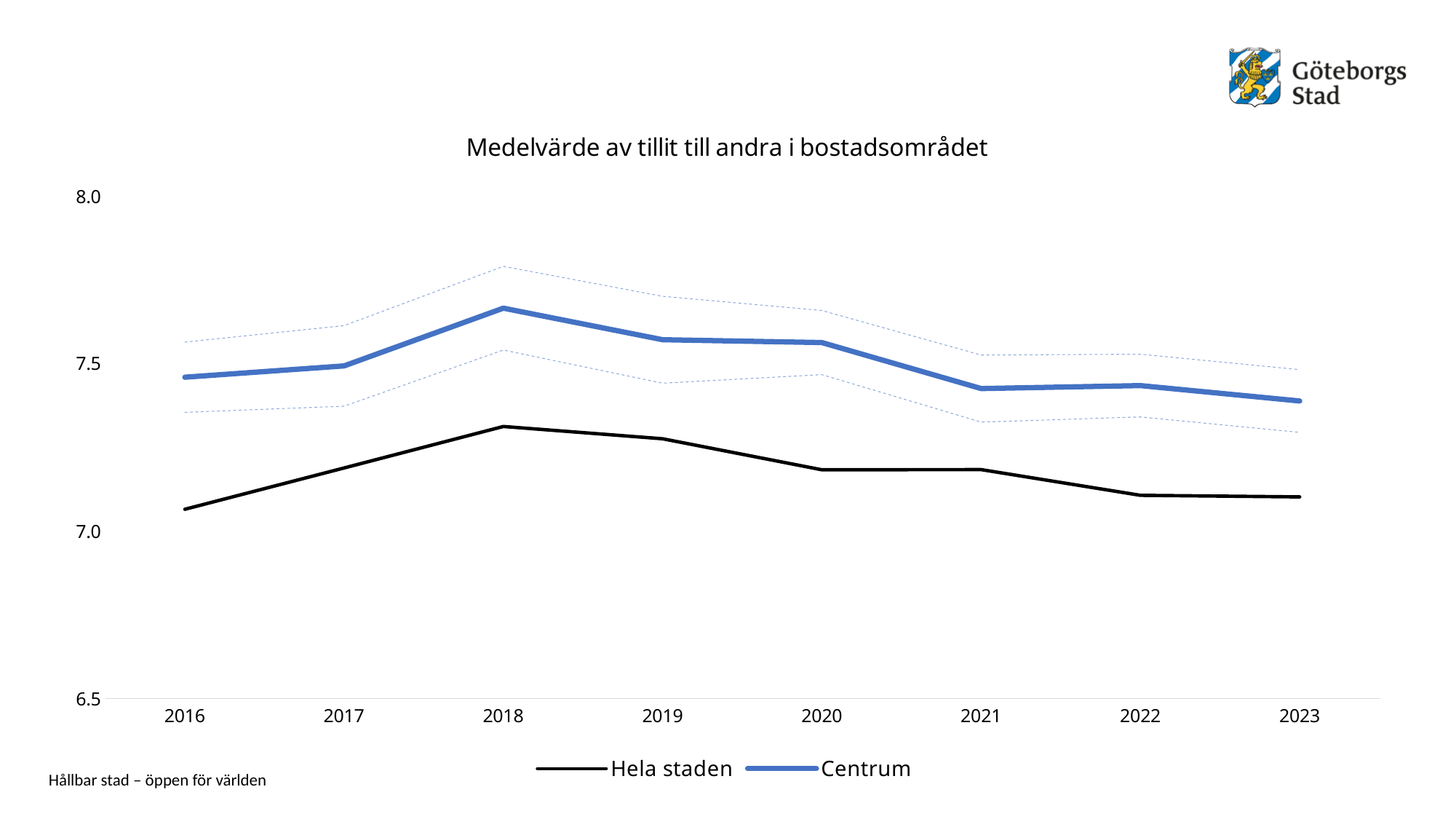
Does the Hela staden series rise or fall from 2018 to 2023? fall What kind of chart is shown on the slide? line chart Is the value for Centrum in 2018 greater or less than 7.5? greater How many years are plotted along the x axis? 8 Is the value for Hela staden in 2016 greater or less than 7.5? less In which year does the Hela staden series reach its highest value? 2018 Which series has the higher value in 2019, Hela staden or Centrum? Centrum Is the value for Hela staden in 2023 greater or less than 7.0? greater How many series does the legend list? 2 In which year does the Centrum series reach its highest value? 2018 What is the title of the chart? Medelvärde av tillit till andra i bostadsområdet In which year is the Hela staden series at its lowest? 2016